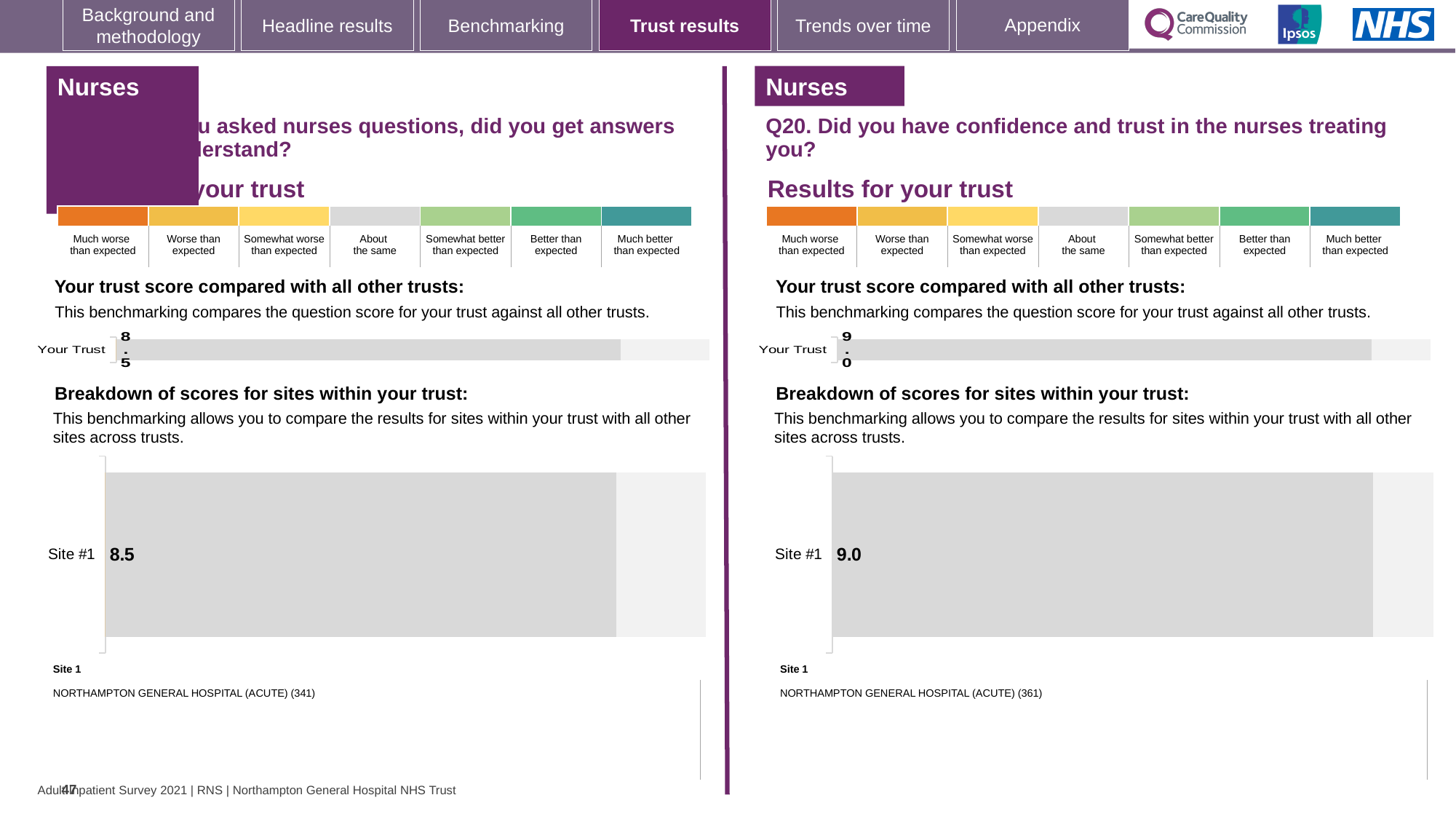
On the left-hand side of the slide, what is the score shown for Your Trust? 8.5 On the right-hand side (Q20), which site is listed as Site 1? NORTHAMPTON GENERAL HOSPITAL (ACUTE) (361) On the left-hand side of the slide, which site is listed as Site 1? NORTHAMPTON GENERAL HOSPITAL (ACUTE) (341) How many sites are shown in the 'Breakdown of scores for sites within your trust' chart on the right-hand side (Q20)? 1 Which is larger: the Site #1 score on the left-hand side or the Site #1 score on the right-hand side (Q20)? Right-hand side (Q20) On the left-hand side of the slide, what is the score shown for Site #1? 8.5 What kind of chart is used to show the Site #1 score on the left-hand side of the slide? Bar chart What is the difference between the Site #1 score on the right-hand side (Q20) and the Site #1 score on the left-hand side? 0.5 Is the Your Trust score on the right-hand side (Q20) the same as the Site #1 score on the right-hand side? Yes On the right-hand side (Q20), what is the score shown for Site #1? 9.0 On the right-hand side (Q20), what is the score shown for Your Trust? 9.0